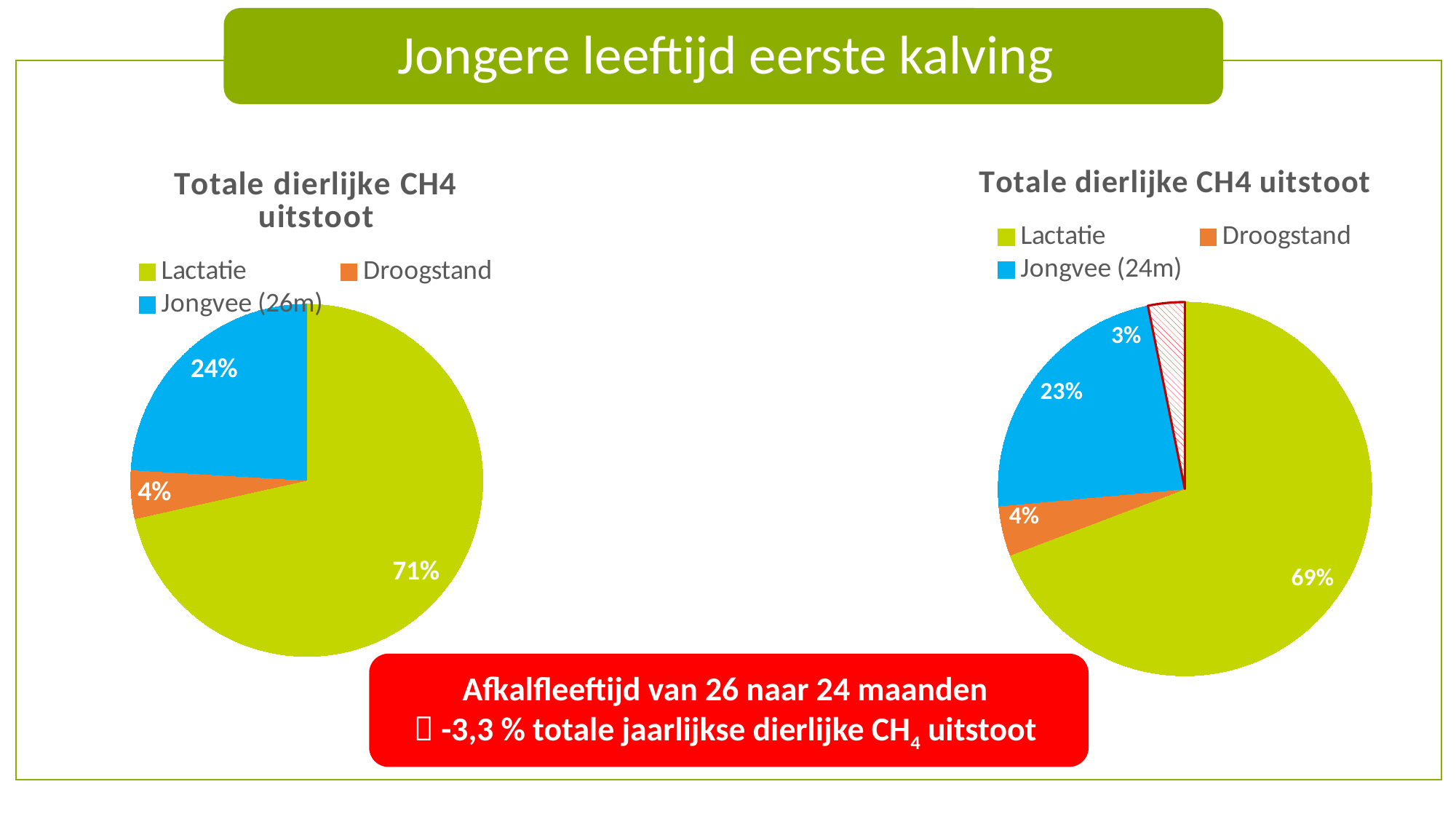
What is the title of the left pie chart? Totale dierlijke CH4 uitstoot How many entries does the legend of the right pie chart list? 3 In the right pie chart, what is the value for Jongvee (24m)? 23% What type of chart is used on the left side of the slide? Pie chart In the right pie chart, what is the value for Lactatie? 69% In the left pie chart, which category has the smallest share? Droogstand In the left pie chart, what is the difference between the Lactatie share and the Jongvee (26m) share? 47% Which is larger: the Jongvee share in the left pie chart (26m) or in the right pie chart (24m)? Left pie chart (26m) In the left pie chart, which category has the largest share? Lactatie In the left pie chart, what is the value for Jongvee (26m)? 24% In the left pie chart, what share of total animal CH4 emissions comes from Lactatie? 71% In the right pie chart, what is the value for Droogstand? 4%